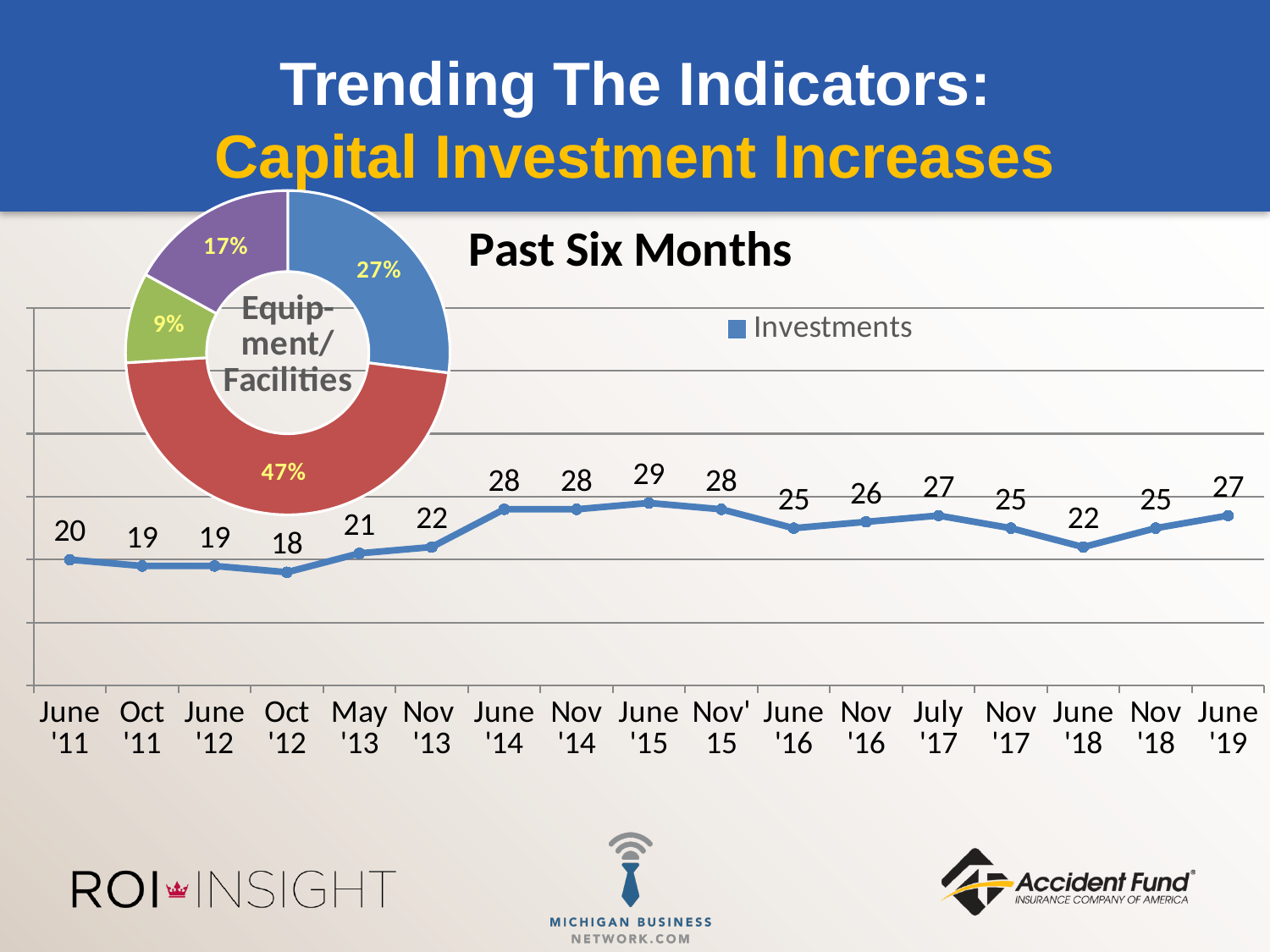
How many data points are plotted in the 'Past Six Months' line chart? 17 How many slices does the 'Equipment/Facilities' doughnut chart have? 4 What type of chart is the 'Past Six Months' chart? Line chart In the 'Past Six Months' line chart, which period has the highest value? June '15 In the 'Equipment/Facilities' doughnut chart, what is the largest share shown? 47% In the 'Past Six Months' line chart, what is the value for Oct '12? 18 In the 'Past Six Months' line chart, which period has the lowest value? Oct '12 In the 'Past Six Months' line chart, what is the value for June '19? 27 In the 'Past Six Months' line chart, which is larger, the value for Nov '16 or the value for Nov '17? Nov '16 In the 'Past Six Months' line chart, what is the difference between the values for June '15 and June '18? 7 In the 'Past Six Months' line chart, do the values rise or fall from Oct '12 to June '14? Rise